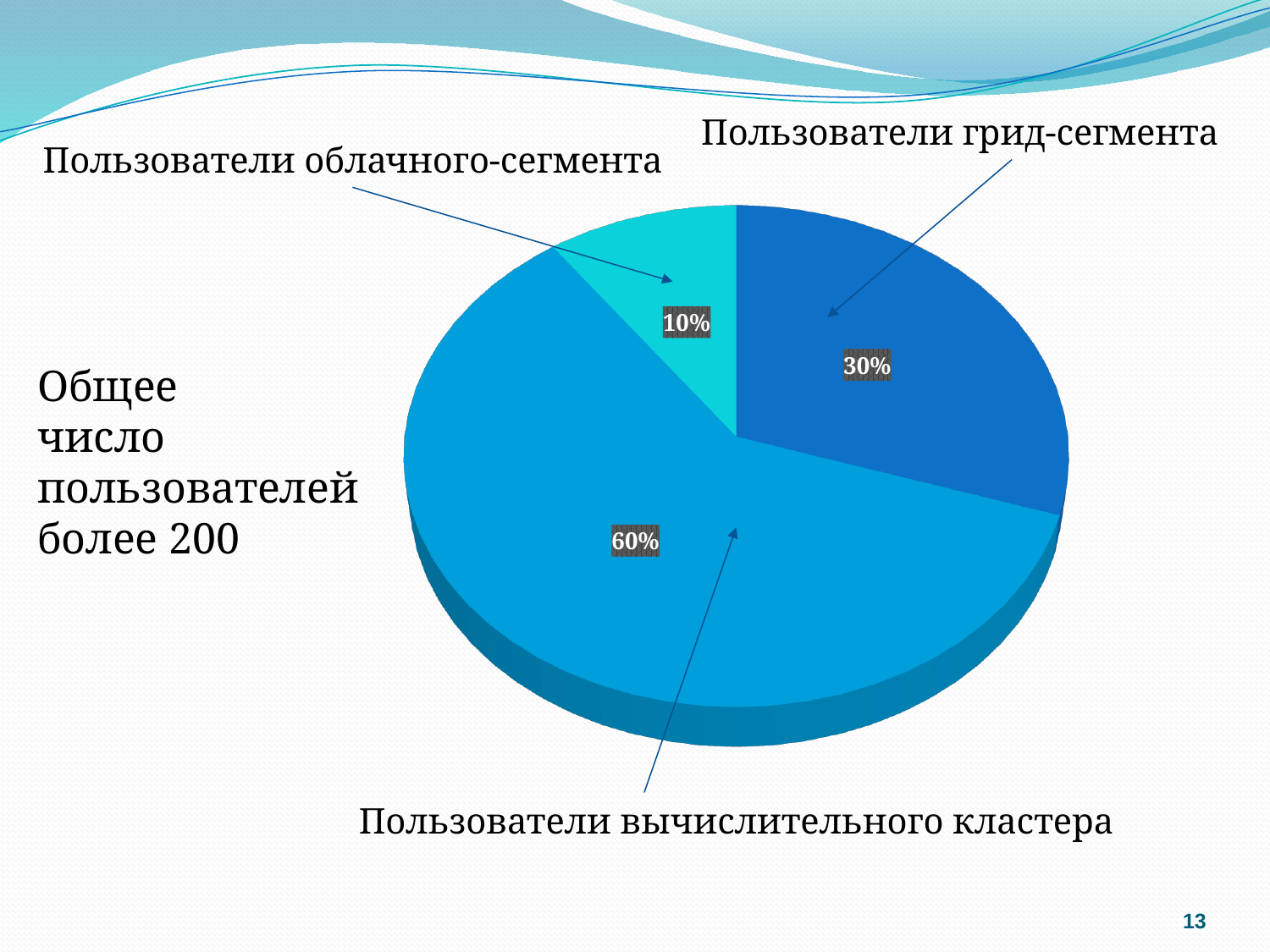
Which is larger: the "Пользователи грид-сегмента" slice or the "Пользователи облачного-сегмента" slice? Пользователи грид-сегмента Which slice is pointed to by the label "Пользователи облачного-сегмента"? the 10% slice What share of the pie is labelled "Пользователи облачного-сегмента"? 10% What share of the pie is labelled "Пользователи вычислительного кластера"? 60% Which slice of the pie is the smallest? Пользователи облачного-сегмента How many slices does the pie chart have? 3 What is the difference in percentage points between the "Пользователи грид-сегмента" slice and the "Пользователи облачного-сегмента" slice? 20% What kind of chart is shown on the slide? pie chart According to the text on the slide, what is the total number of users? более 200 What share of the pie is labelled "Пользователи грид-сегмента"? 30% What is the difference in percentage points between the "Пользователи вычислительного кластера" slice and the "Пользователи грид-сегмента" slice? 30% Which slice of the pie is the largest? Пользователи вычислительного кластера